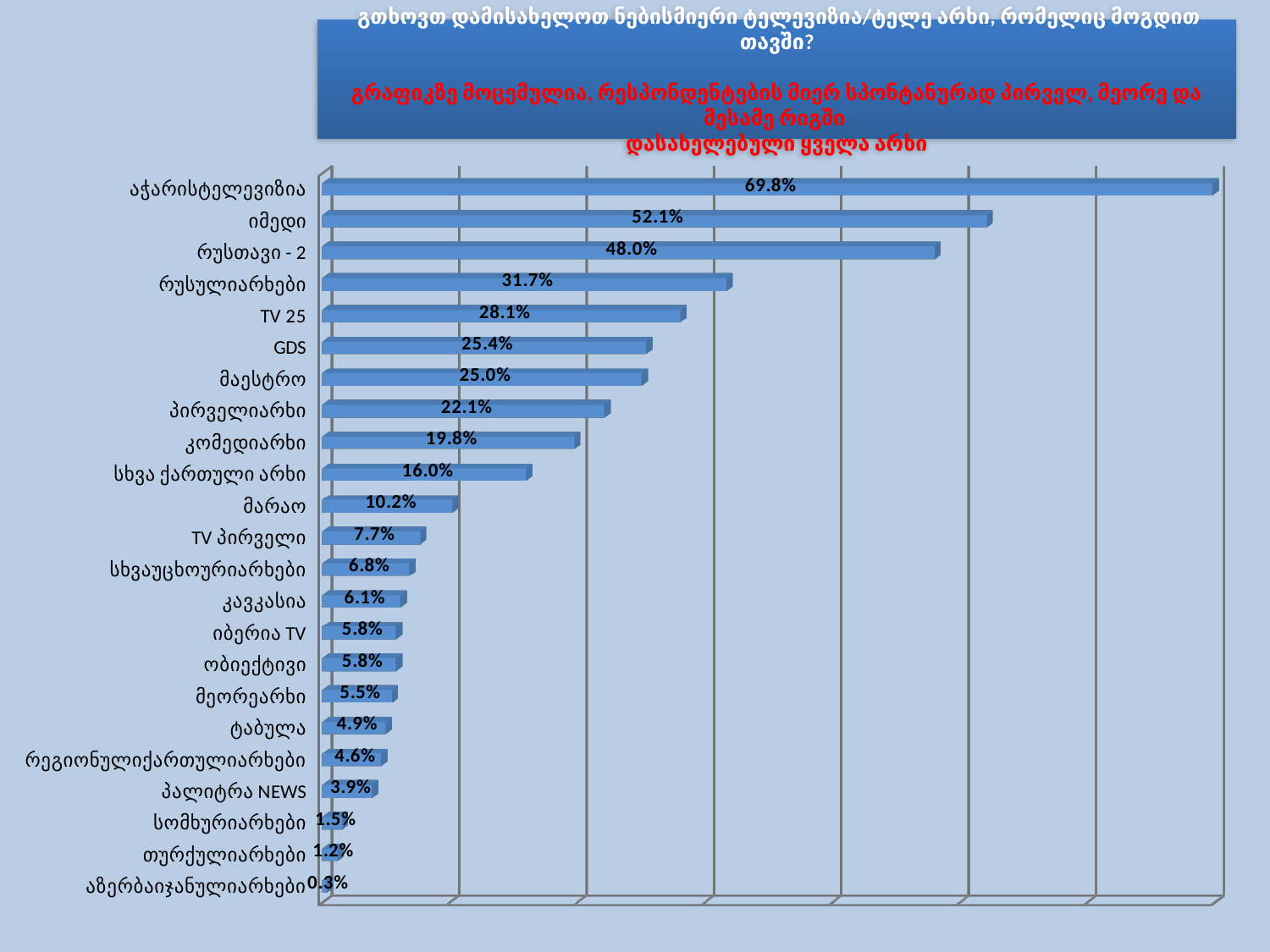
What is the value for იმედი? 52.1% Which is larger, the value for მაესტრო or the value for კომედიარხი? მაესტრო Which category has the lowest value? აზერბაიჯანულიარხები What is the difference between the values for იმედი and რუსთავი - 2? 4.1% What is the value for GDS? 25.4% What is the difference between the values for აჭარისტელევიზია and TV 25? 41.7% How many categories are shown in the chart? 23 What is the value for პალიტრა NEWS? 3.9% Which category has the highest value? აჭარისტელევიზია What is the value for TV 25? 28.1% What is the value for TV პირველი? 7.7% What kind of chart is shown on the slide? Bar chart